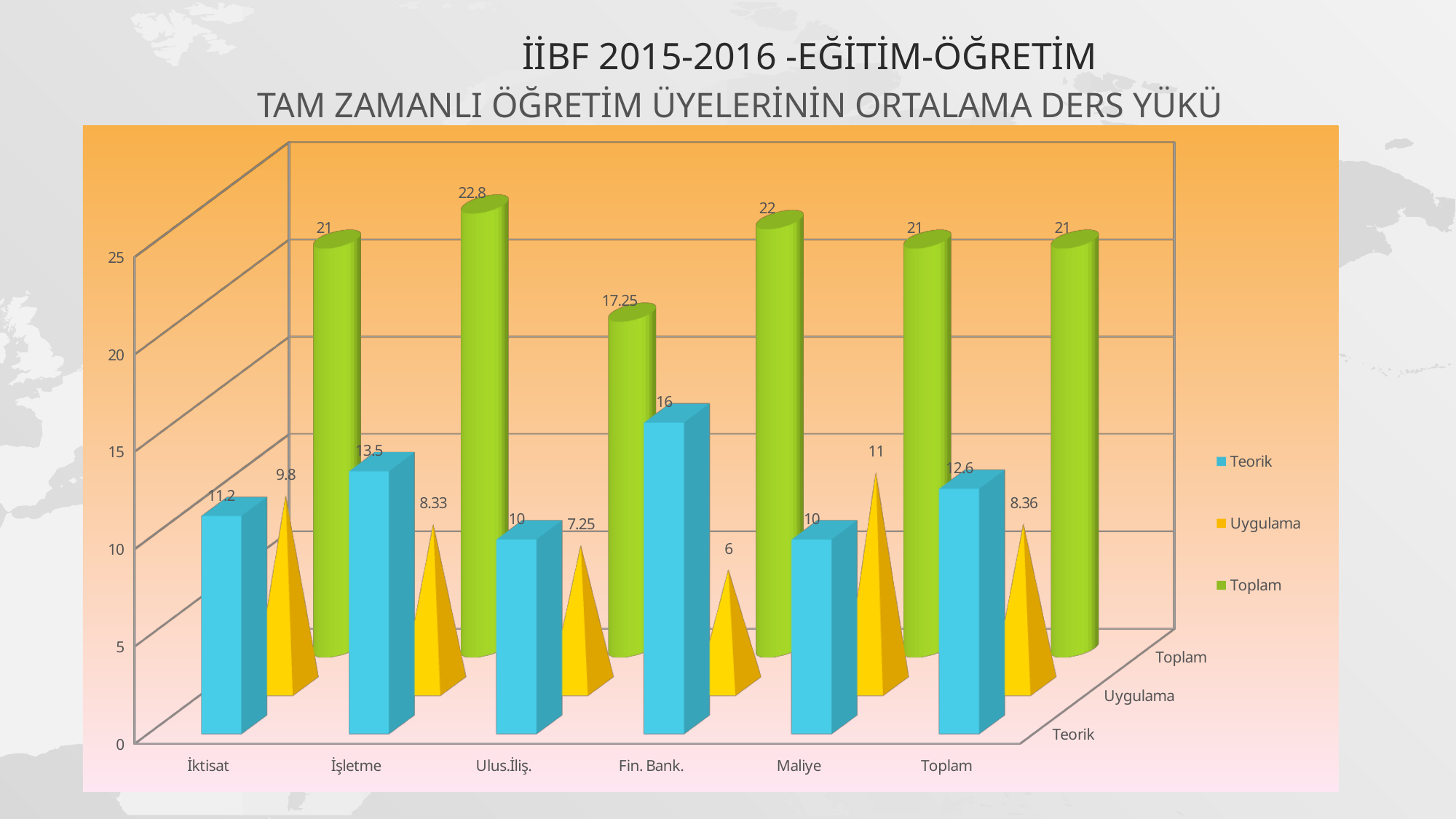
How many categories are shown on the x axis? 6 Which category has the lowest Uygulama value? Fin. Bank. Which category has the highest Teorik value? Fin. Bank. What is the difference between the Teorik values for Fin. Bank. and Maliye? 6 Which category has the highest Toplam value? İşletme What kind of chart is shown on the slide? bar chart Which has the larger Uygulama value, İktisat or İşletme? İktisat What is the Uygulama value for Maliye? 11 What is the Toplam value for Ulus.İliş.? 17.25 What is the Toplam value for İşletme? 22.8 What is the Teorik value for İktisat? 11.2 How many series does the legend list? 3